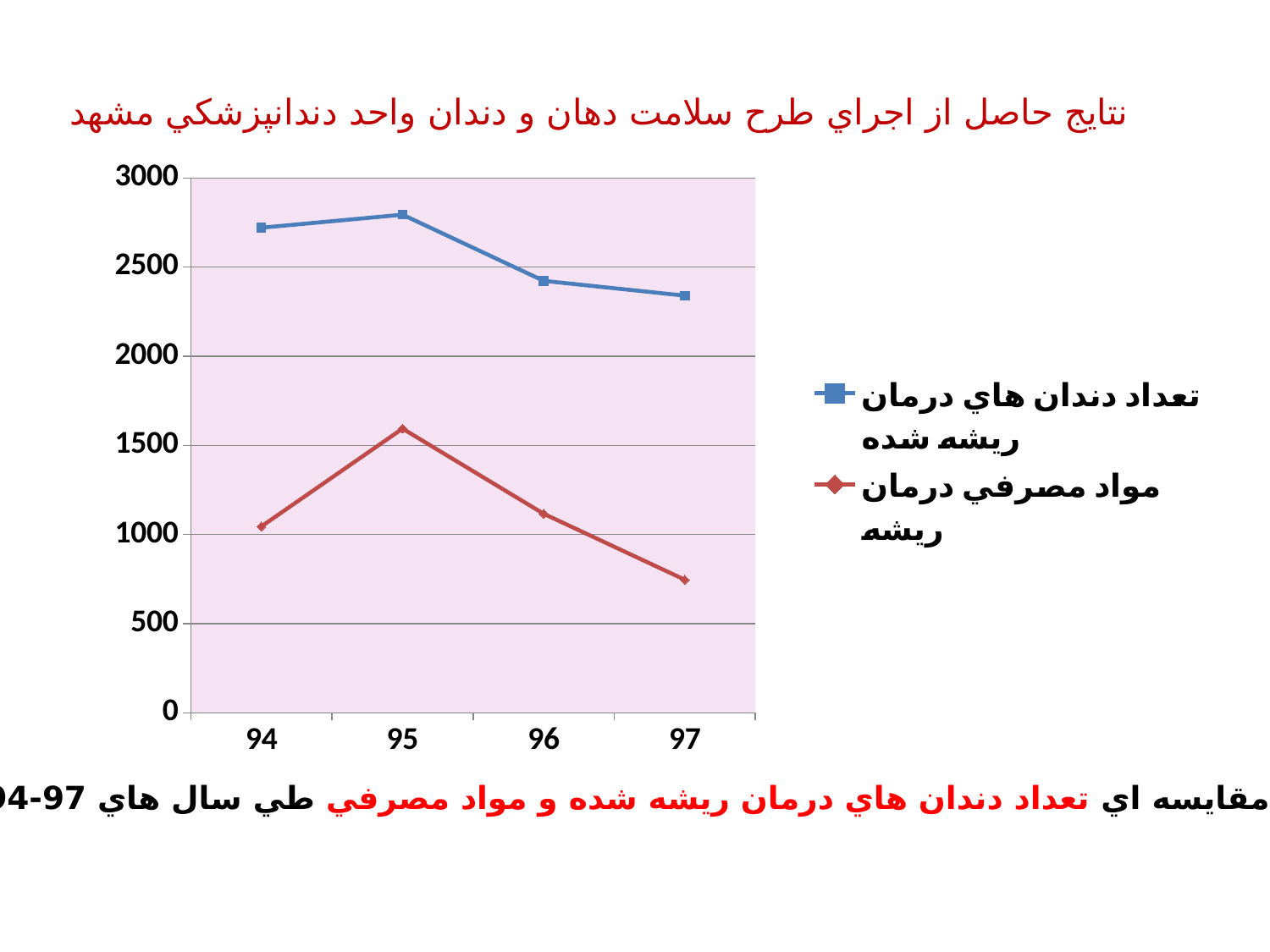
Does the series مواد مصرفي درمان ريشه rise or fall from 95 to 97? fall In which year does the series مواد مصرفي درمان ريشه reach its lowest value? 97 In which year does the series مواد مصرفي درمان ريشه reach its highest value? 95 How many series does the legend list? 2 Is the value for تعداد دندان هاي درمان ريشه شده in 94 greater or less than 2500? greater What kind of chart is shown on the slide? line chart In 95, which series has the larger value, تعداد دندان هاي درمان ريشه شده or مواد مصرفي درمان ريشه? تعداد دندان هاي درمان ريشه شده Is the value for مواد مصرفي درمان ريشه in 97 greater or less than 1000? less How many years are plotted along the x axis? 4 Is the value for مواد مصرفي درمان ريشه in 95 greater or less than 1500? greater Which colour is used for the series تعداد دندان هاي درمان ريشه شده? blue